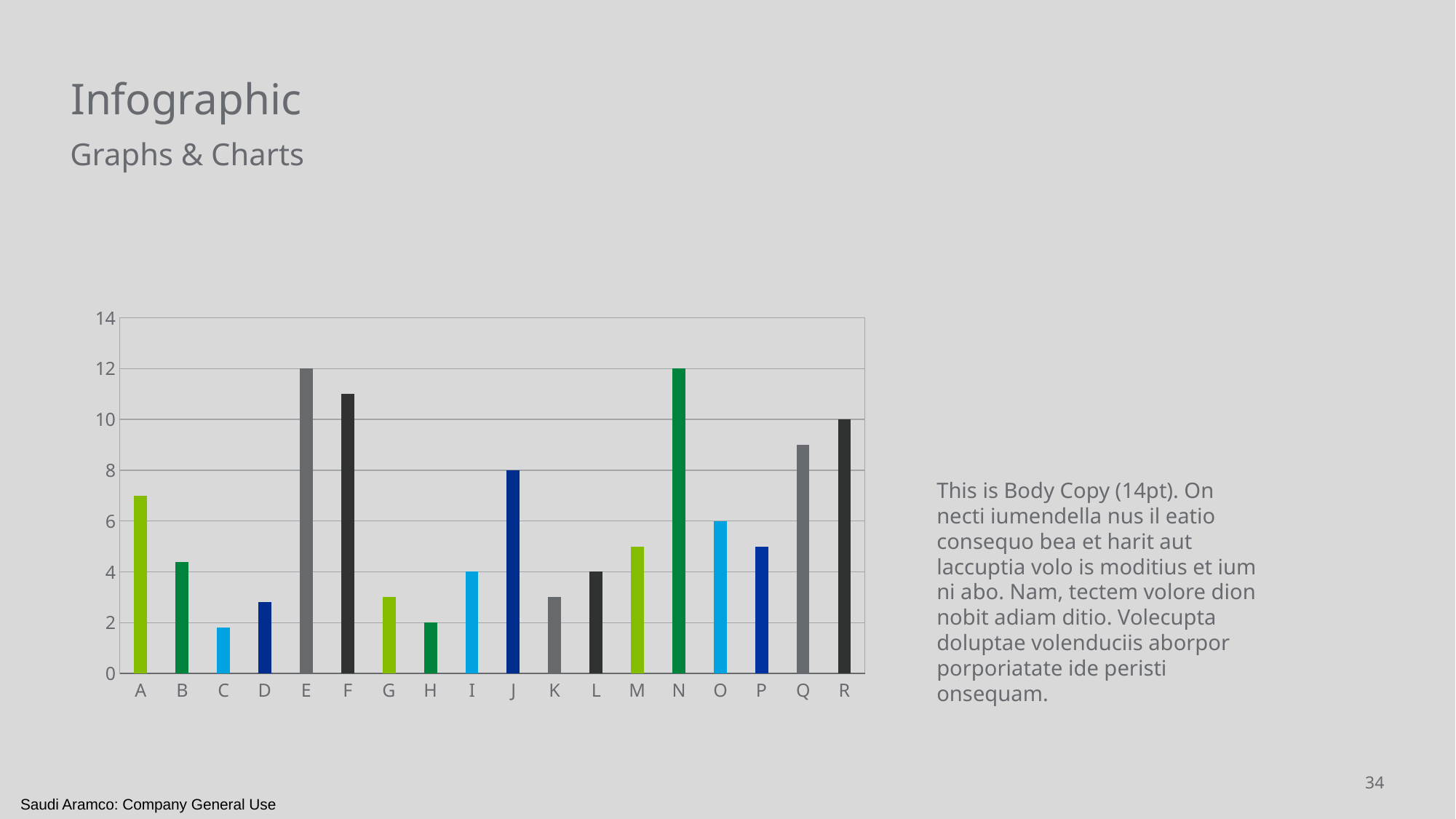
What is the difference between the values for E and J? 4 What is the value for category O? 6 Which is larger, the value for R or the value for M? R Is the value for D greater or less than 4? less What kind of chart is shown on the slide? Bar chart How many categories are shown on the x axis? 18 What is the value for category H? 2 What is the value for category E? 12 Which is larger, the value for E or the value for A? E What is the value for category J? 8 Is the value for F greater or less than 10? greater What is the value for category R? 10